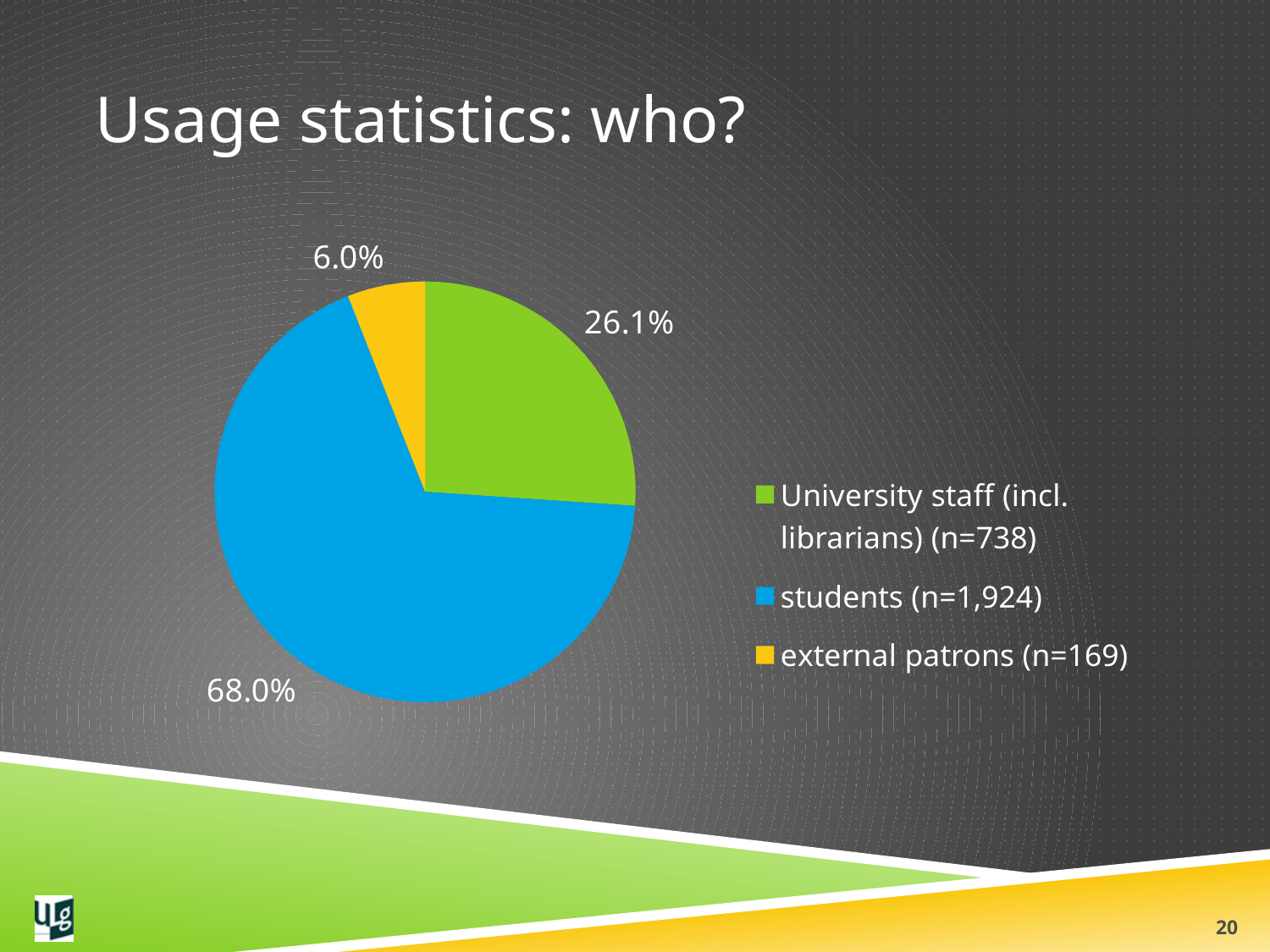
Which category has the smallest slice of the pie? external patrons (n=169) What is the difference in percentage points between the students slice and the University staff slice? 41.9 What share of the pie do students account for? 68.0% What share of the pie do external patrons account for? 6.0% Which category has the largest slice of the pie? students (n=1,924) What share of the pie do University staff (incl. librarians) account for? 26.1% What is the difference in percentage points between the University staff slice and the external patrons slice? 20.1 What kind of chart is shown on the slide? pie chart How many categories does the pie chart show? 3 Which slice is larger: University staff (incl. librarians) or external patrons? University staff (incl. librarians) What colour is the slice for external patrons? yellow What is the sample size (n) given in the legend for students? 1,924